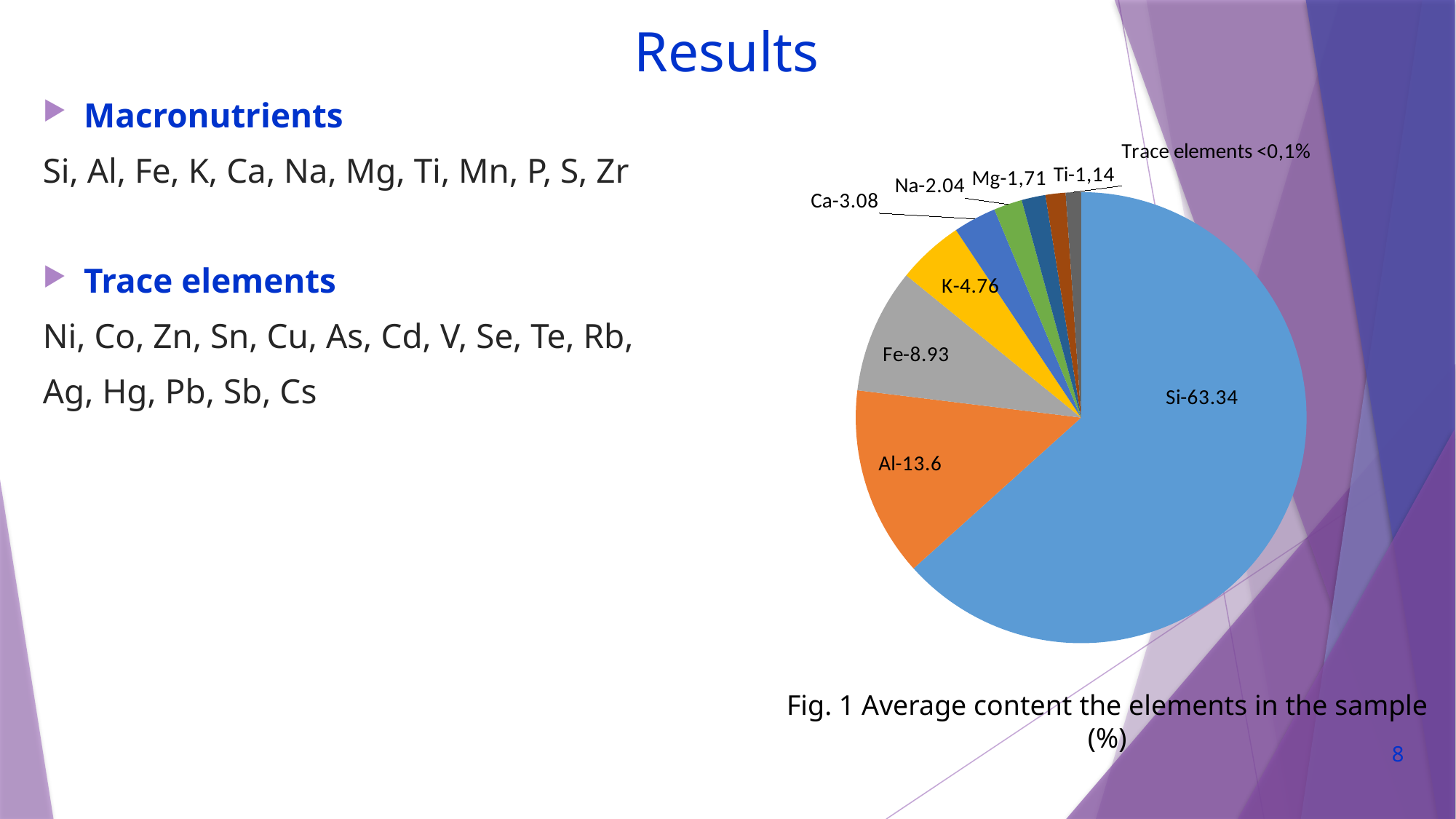
What is the value shown for Ca in the pie chart? 3.08 How many slices does the pie chart have? 9 Which of Al or Fe has the larger value in the pie chart? Al What is the caption of the pie chart? Fig. 1 Average content the elements in the sample (%) What is the value shown for Si in the pie chart? 63.34 What kind of chart is shown on the slide? pie chart What is the value shown for K in the pie chart? 4.76 What is the difference between the values for Si and Al? 49.74 What is the value shown for Al in the pie chart? 13.6 Which element has the largest slice in the pie chart? Si What value is shown for the Trace elements slice? <0,1% What is the value shown for Fe in the pie chart? 8.93